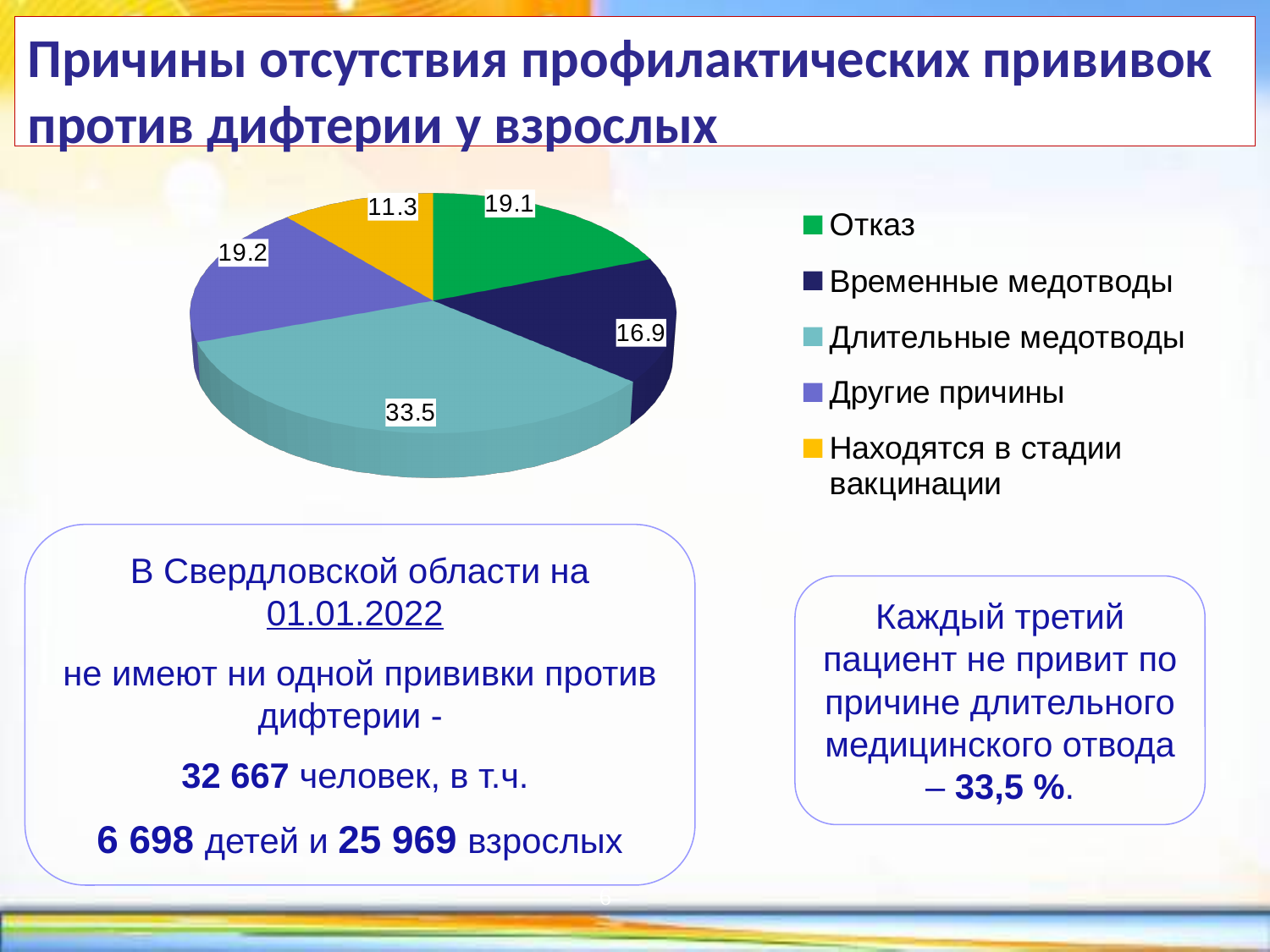
Which category has the smallest slice of the pie chart? Находятся в стадии вакцинации What is the difference between the values for Длительные медотводы and Временные медотводы? 16.6 How many categories does the pie chart show? 5 What is the value shown for the Длительные медотводы slice? 33.5 What is the value shown for the Отказ slice of the pie chart? 19.1 What type of chart is shown on the slide? Pie chart What is the value shown for the Временные медотводы slice? 16.9 Which is larger, the slice for Другие причины or the slice for Временные медотводы? Другие причины Which colour represents Длительные медотводы in the legend? Teal (light blue-green) What is the difference between the values for Отказ and Находятся в стадии вакцинации? 7.8 Which category has the largest slice of the pie chart? Длительные медотводы What is the value shown for the Находятся в стадии вакцинации slice? 11.3